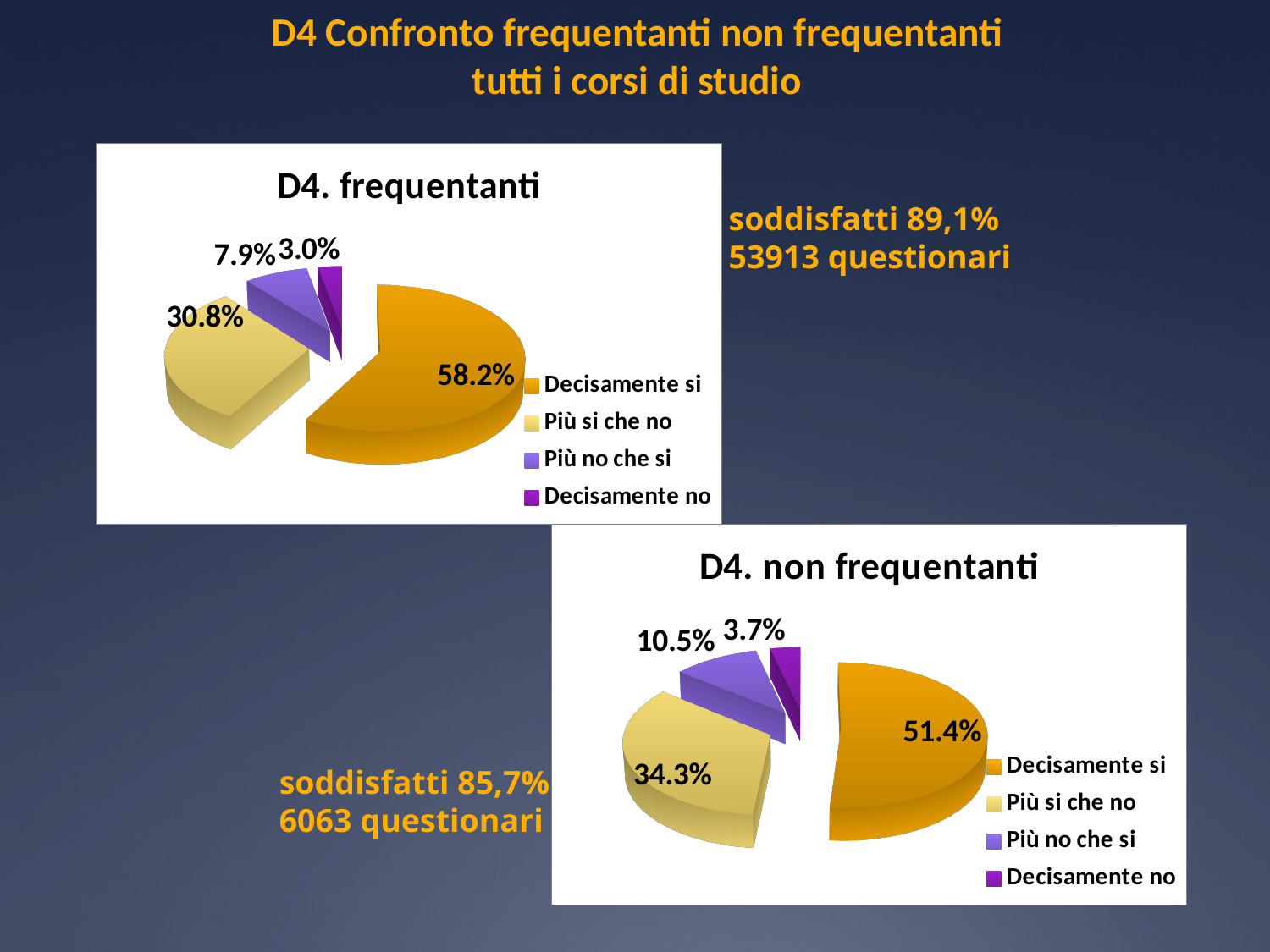
How many slices does the 'D4. non frequentanti' chart have? 4 In the 'D4. frequentanti' chart, which category has the largest slice? Decisamente si In the 'D4. non frequentanti' chart, which category has the smallest slice? Decisamente no In the 'D4. non frequentanti' chart, what is the value for 'Più si che no'? 34.3% What kind of chart is 'D4. frequentanti'? Pie chart How many entries does the legend of the 'D4. frequentanti' chart list? 4 In the 'D4. non frequentanti' chart, what colour is the 'Più no che si' slice? Purple In the 'D4. frequentanti' chart, what is the value for 'Decisamente si'? 58.2% Which is larger: 'Decisamente si' in the 'D4. frequentanti' chart or 'Decisamente si' in the 'D4. non frequentanti' chart? D4. frequentanti In the 'D4. frequentanti' chart, what is the difference between 'Decisamente si' and 'Più si che no'? 27.4% In the 'D4. frequentanti' chart, what is the value for 'Più no che si'? 7.9% In the 'D4. non frequentanti' chart, what is the value for 'Decisamente no'? 3.7%